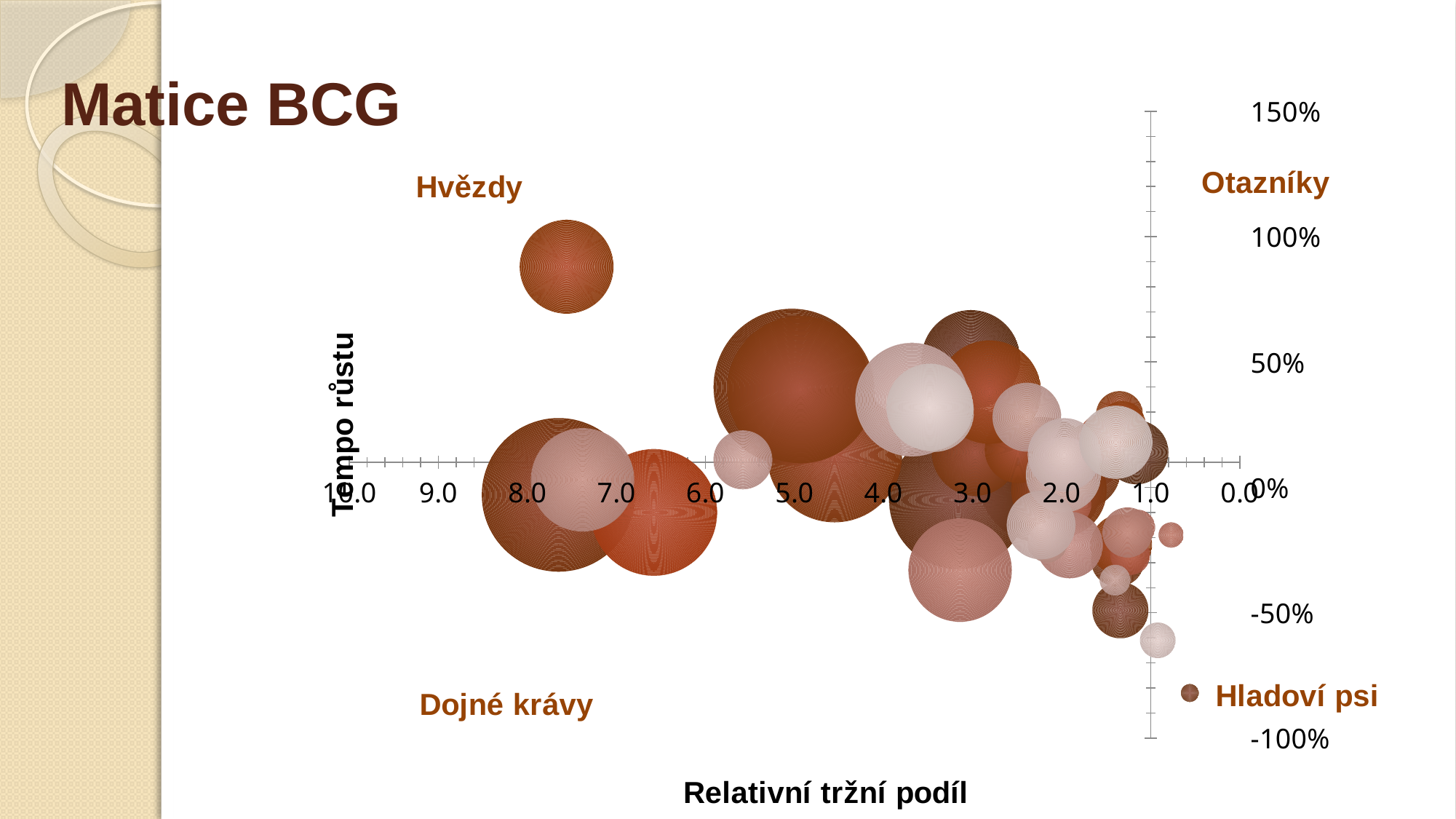
Is the growth rate of the lowest bubble near the vertical axis (just below the Hladoví psi label area) greater or less than 0%? less What is the title of the slide containing the chart? Matice BCG Is the relative market share of the single bubble in the Hvězdy quadrant greater or less than 7.0? greater Is the growth rate (Tempo růstu) of the single bubble in the Hvězdy quadrant greater or less than 100%? less What kind of chart is shown on the slide? bubble chart What label is shown on the horizontal axis of the chart? Relativní tržní podíl